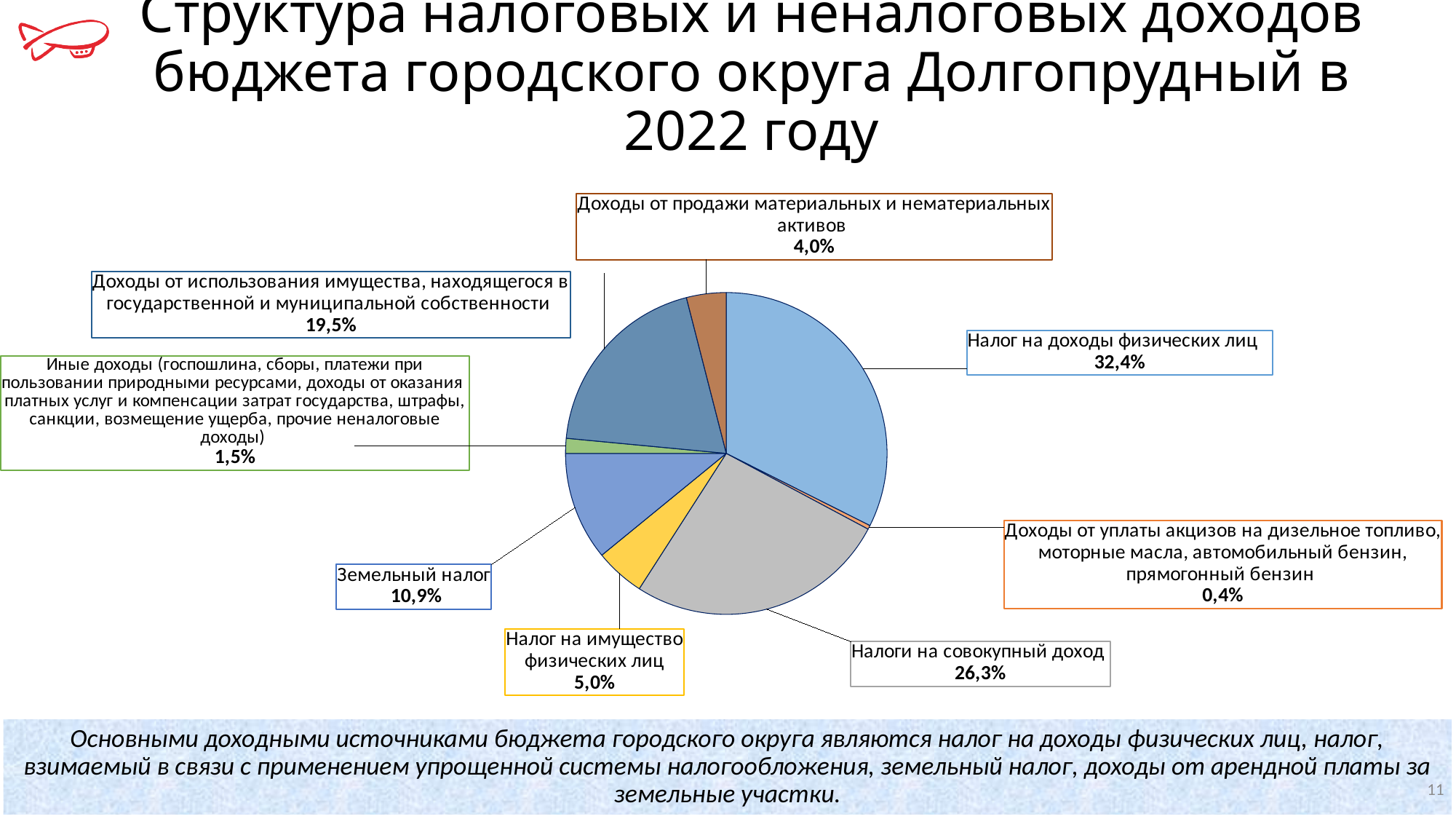
How many slices does the pie chart have? 8 What share is shown for Налог на имущество физических лиц? 5,0% What is the difference in percentage points between Налог на доходы физических лиц and Налоги на совокупный доход? 6,1 What kind of chart is shown on the slide? Pie chart What share of the budget revenue is Налог на доходы физических лиц? 32,4% What percentage is shown for Земельный налог? 10,9% Which category has the smallest share of the pie? Доходы от уплаты акцизов на дизельное топливо, моторные масла, автомобильный бензин, прямогонный бензин Which is larger: Земельный налог or Налог на имущество физических лиц? Земельный налог Which category has the largest share of the pie? Налог на доходы физических лиц What share is shown for Налоги на совокупный доход? 26,3% What is the combined share of Иные доходы and Доходы от уплаты акцизов? 1,9% What percentage is shown for Доходы от продажи материальных и нематериальных активов? 4,0%